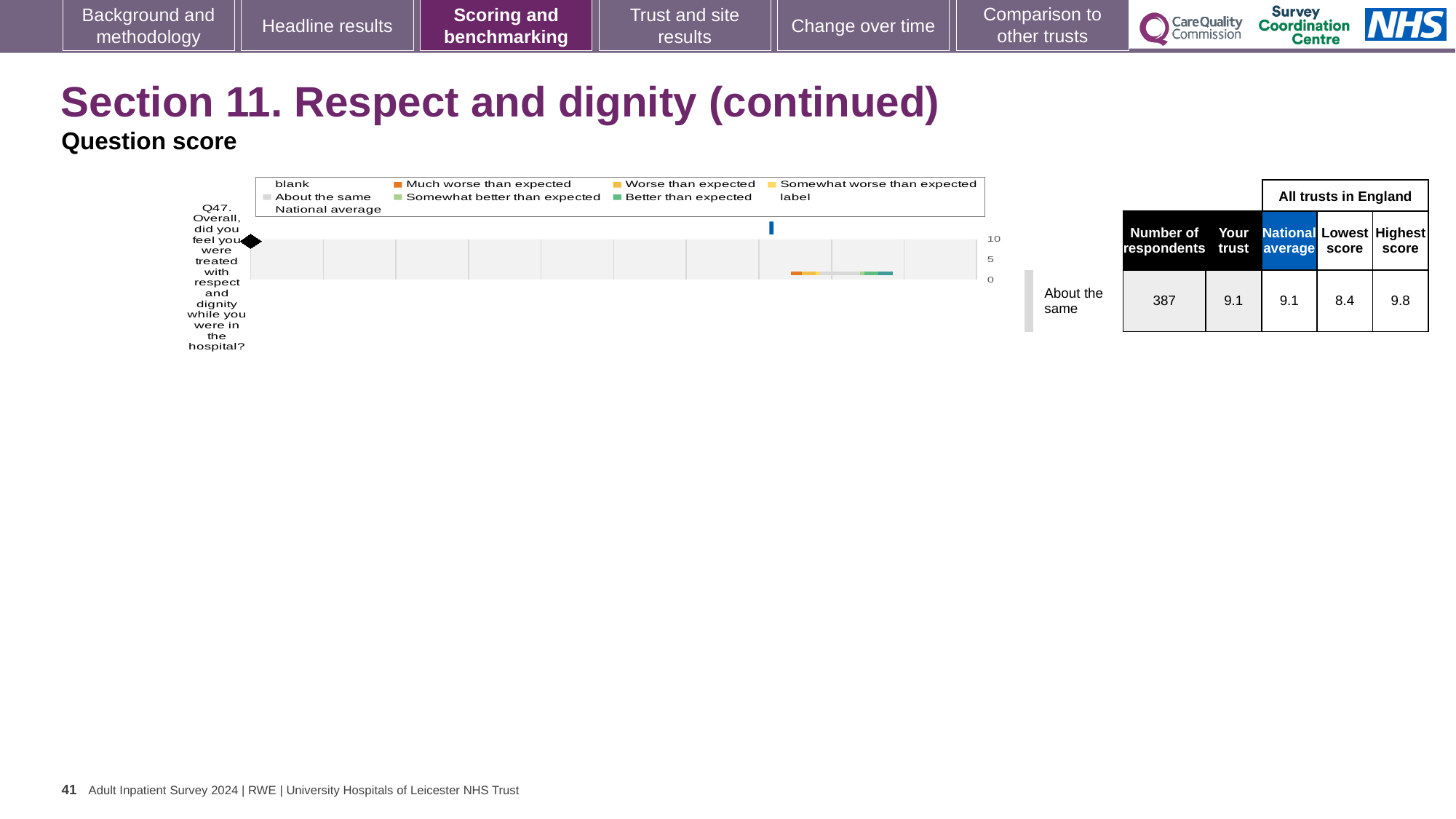
What is the lowest score among all trusts in England for Q47? 8.4 What is the national average score for Q47? 9.1 Is the 'Your trust' score for Q47 greater or less than 5? greater Which question is plotted on the chart? Q47. Overall, did you feel you were treated with respect and dignity while you were in the hospital? How is the trust's result for Q47 categorised relative to expectations? About the same How many respondents answered Q47? 387 How many survey questions are plotted on the chart? 1 What is the difference between the highest and lowest scores for Q47 across all trusts in England? 1.4 What is the highest value shown on the chart's score axis? 10 What is the 'Your trust' score for Q47? 9.1 What is the highest score among all trusts in England for Q47? 9.8 What kind of chart is shown on the slide for Q47? bar chart